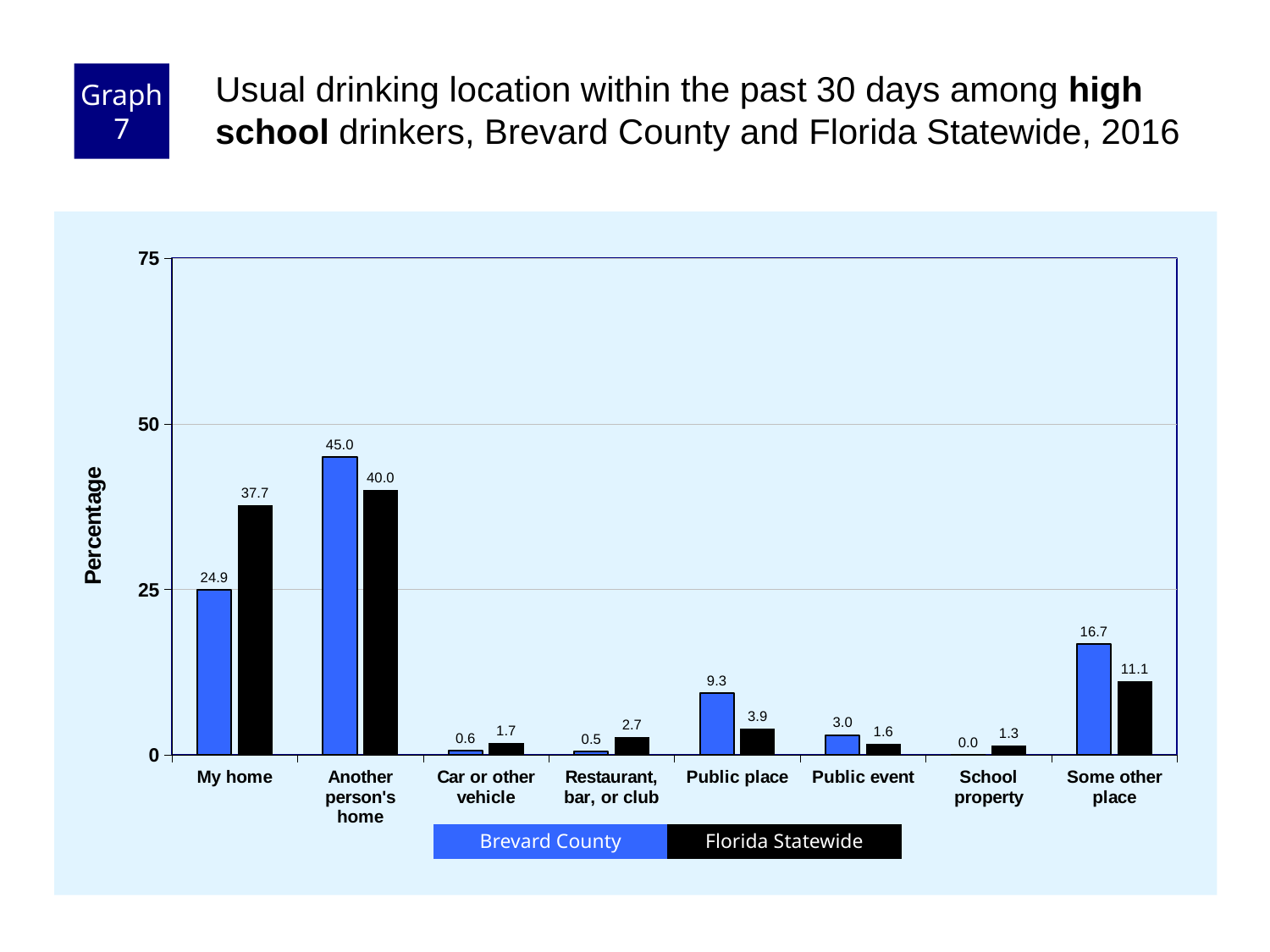
What is the Florida Statewide value for "Another person's home"? 40.0 Which category has the highest Brevard County value? Another person's home What is the Brevard County value for "My home"? 24.9 What is the Brevard County value for "Public place"? 9.3 What is the label of the y axis? Percentage Which category has the lowest Brevard County value? School property Which is larger for "Some other place": Brevard County or Florida Statewide? Brevard County What is the difference between the Florida Statewide and Brevard County values for "My home"? 12.8 How many categories are shown on the x axis? 8 What kind of chart is shown on the slide? Bar chart How many series does the legend list? 2 Is the Brevard County value for "Another person's home" greater or less than 50? less